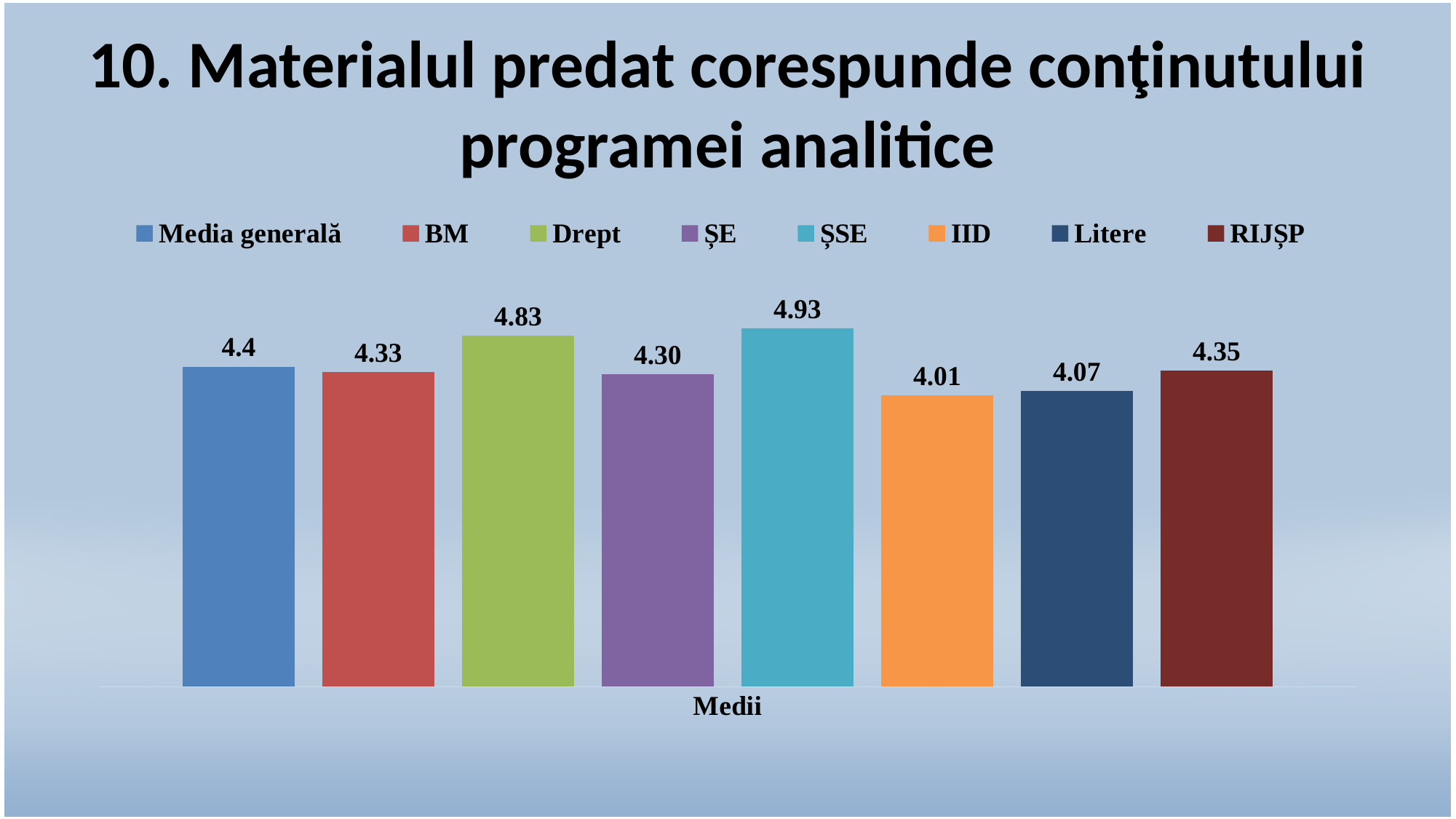
Which series has the highest value? ȘSE What is the difference between the values for Drept and Litere? 0.76 What is the value for IID? 4.01 What is the label on the x axis of the chart? Medii Which series has the lowest value? IID What is the value for Media generală? 4.4 What is the value for Drept? 4.83 How many series does the legend list? 8 Which is larger, the value for Drept or the value for ȘE? Drept What is the value for RIJȘP? 4.35 What is the difference between the values for ȘSE and IID? 0.92 What kind of chart is shown on the slide? Bar chart